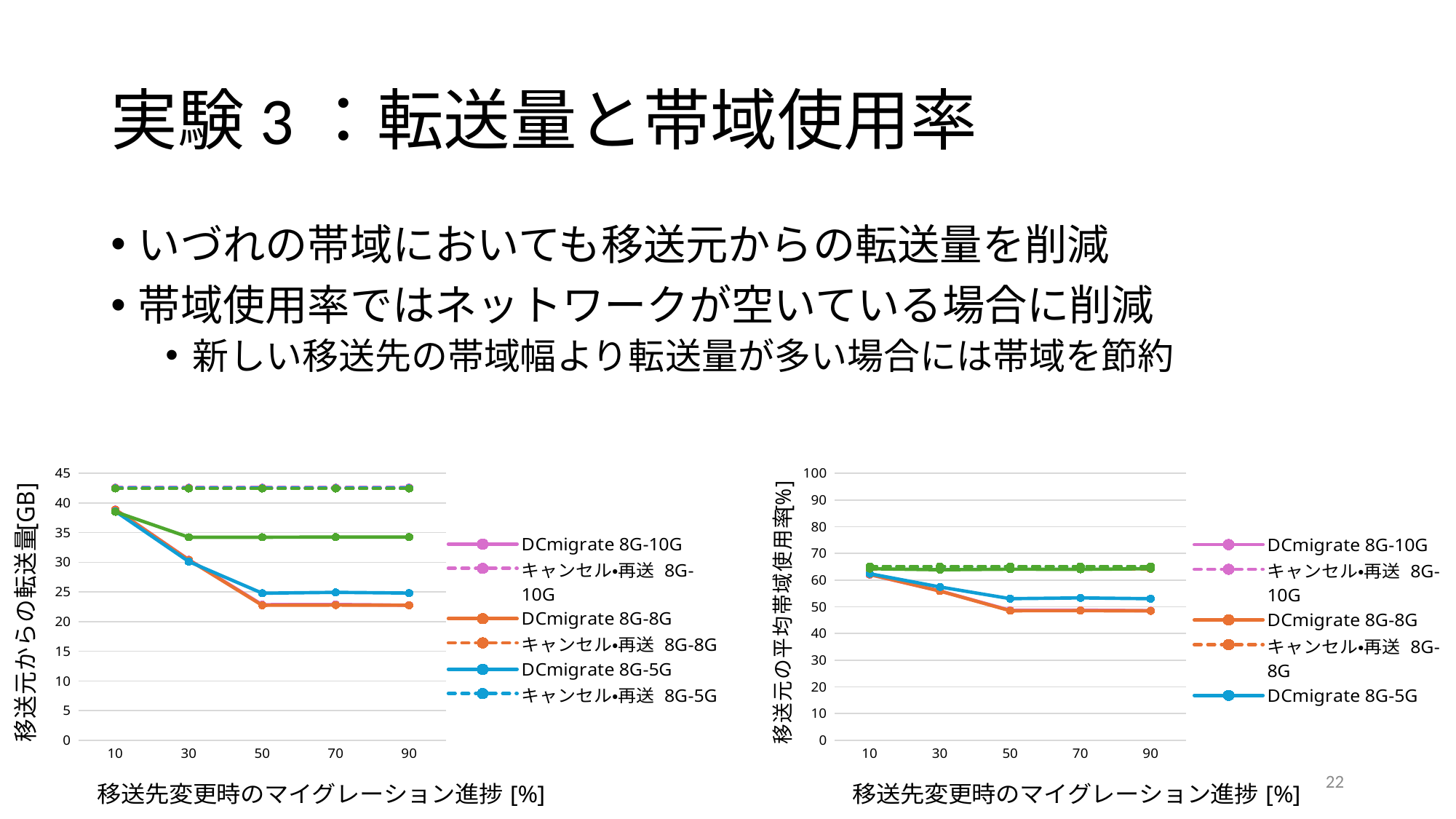
In the right chart, is the value for DCmigrate 8G-5G at 70 greater or less than 50? greater In the left chart, is the value for DCmigrate 8G-8G at 50 greater or less than 25? less How many x-axis points are plotted for each series in the left chart? 5 How many series does the legend of the right chart list? 5 In the left chart, is the value for キャンセル•再送 8G-5G at 90 greater or less than 40? greater What kind of chart is the left chart on the slide? line chart In the right chart, does the DCmigrate 8G-8G series rise or fall from 10 to 50 on the x axis? fall What is the y-axis label of the right chart? 移送元の平均帯域使用率[%] How many series does the legend of the left chart list? 6 In the left chart, at 50, which is larger: DCmigrate 8G-5G or DCmigrate 8G-8G? DCmigrate 8G-5G